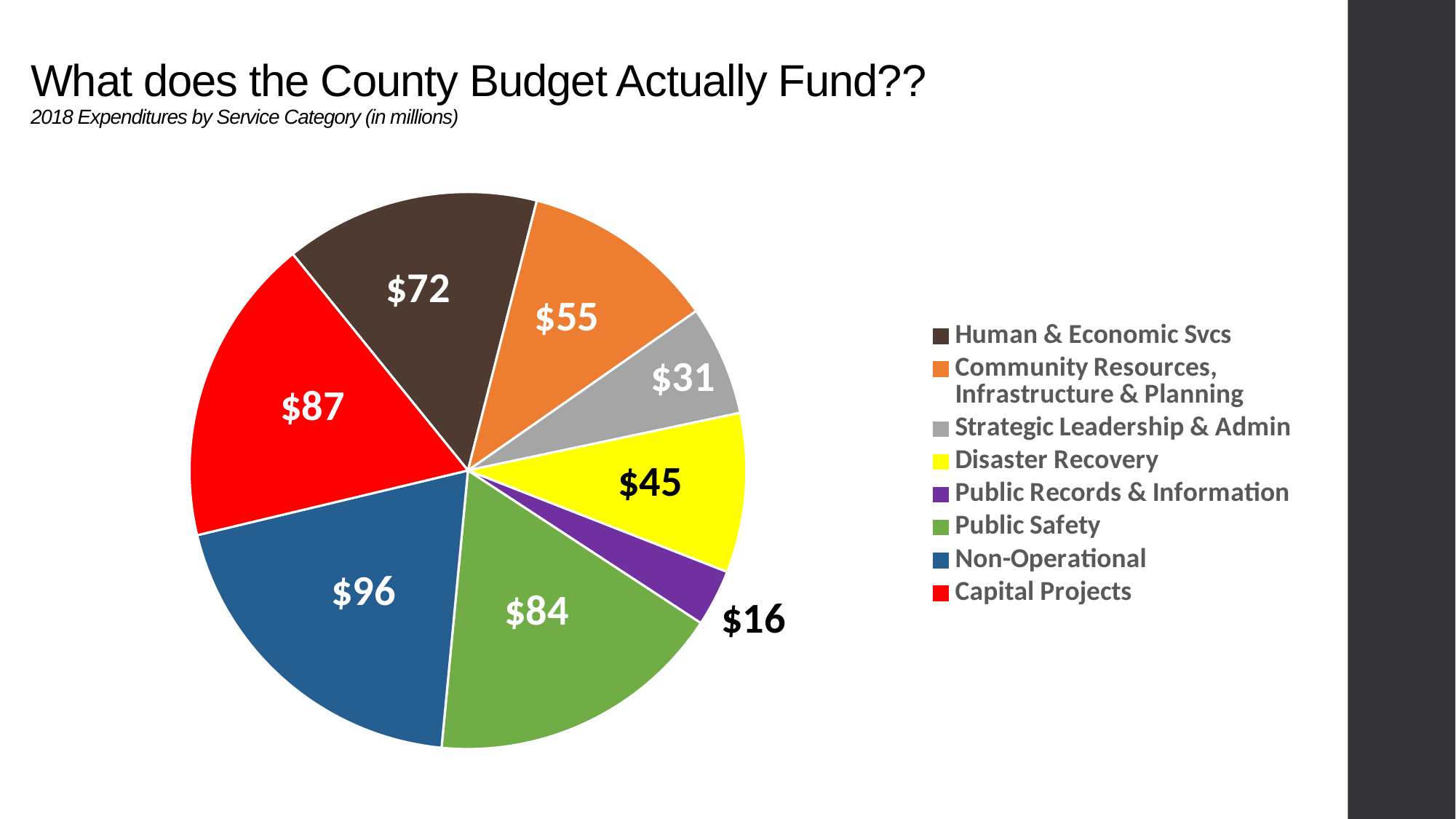
Which service category has the largest expenditure? Non-Operational What is the value for Non-Operational? $96 What type of chart is shown on the slide? Pie chart What is the value for Public Records & Information? $16 Which is larger, Human & Economic Svcs or Community Resources, Infrastructure & Planning? Human & Economic Svcs What colour is the slice for Capital Projects? Red Which service category has the smallest expenditure? Public Records & Information What is the total of all expenditures shown in the pie chart? $486 How many service categories are shown in the pie chart? 8 What is the difference between Capital Projects and Public Safety? $3 What is the value for Disaster Recovery? $45 What is the value for Strategic Leadership & Admin? $31